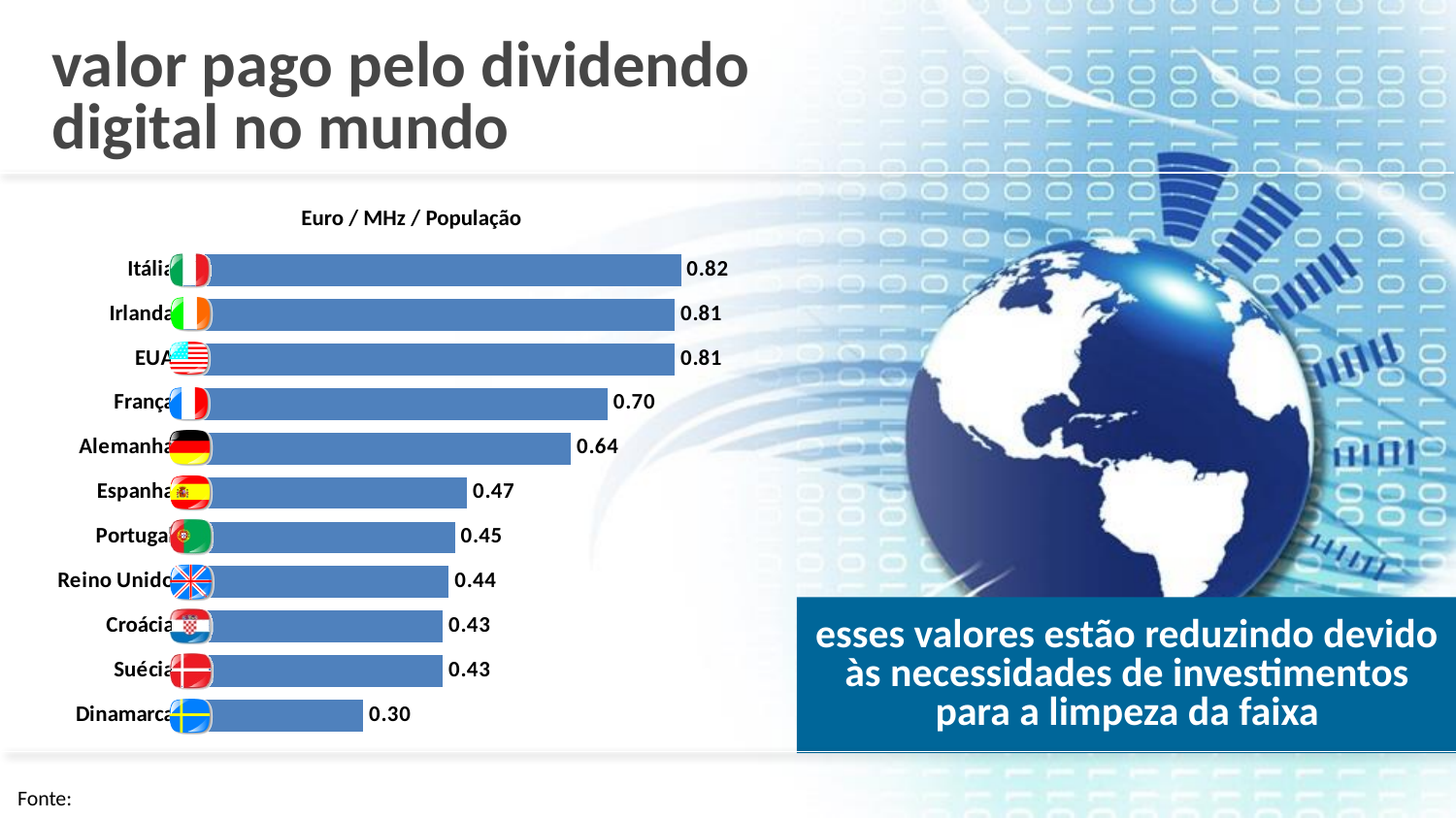
What is the value for Alemanha? 0.64 Which is larger, the value for Portugal or the value for Alemanha? Alemanha Which country has the lowest value? Dinamarca What is the title of the chart? Euro / MHz / População What is the value for Itália? 0.82 How many countries are shown in the chart? 11 What is the difference between the values for Itália and Dinamarca? 0.52 What is the difference between the values for França and Espanha? 0.23 Which country has the highest value? Itália What is the value for Reino Unido? 0.44 What is the value for Dinamarca? 0.30 What kind of chart is shown on the slide? Bar chart